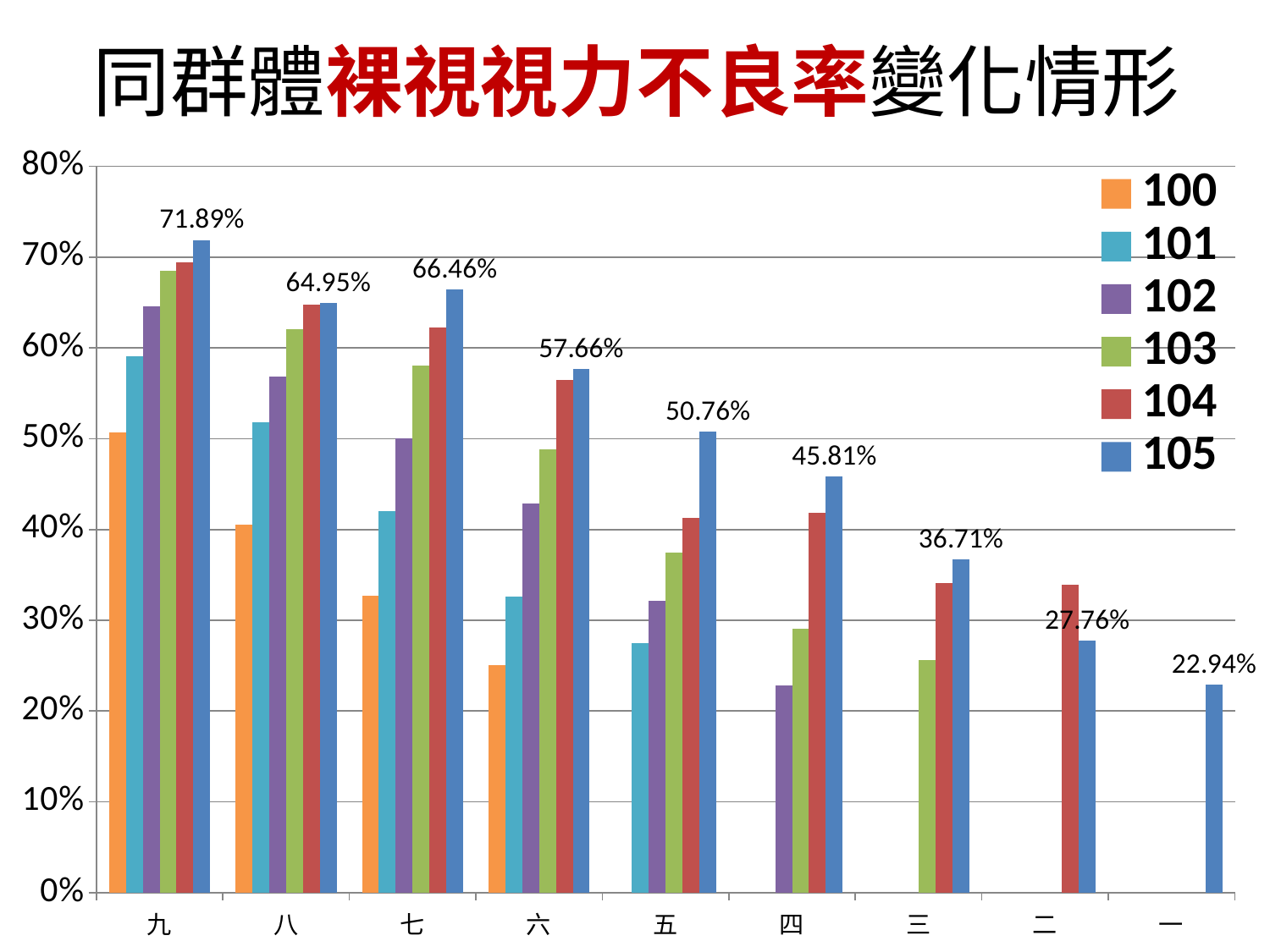
In which category is the series 105 value lowest? 一 What kind of chart is shown on the slide? bar chart Is the value for series 100 in category 七 greater or less than 30%? greater Which is larger for series 105: the value for 八 or the value for 七? 七 What is the value for series 105 in category 一? 22.94% What is the difference between the series 105 values for 九 and 八? 6.94 percentage points Is the value for series 101 in category 五 greater or less than 30%? less What is the value for series 105 in category 五? 50.76% What is the value for series 105 in category 九? 71.89% In which category is the series 105 value highest? 九 How many series does the legend list? 6 How many categories are shown on the x axis? 9